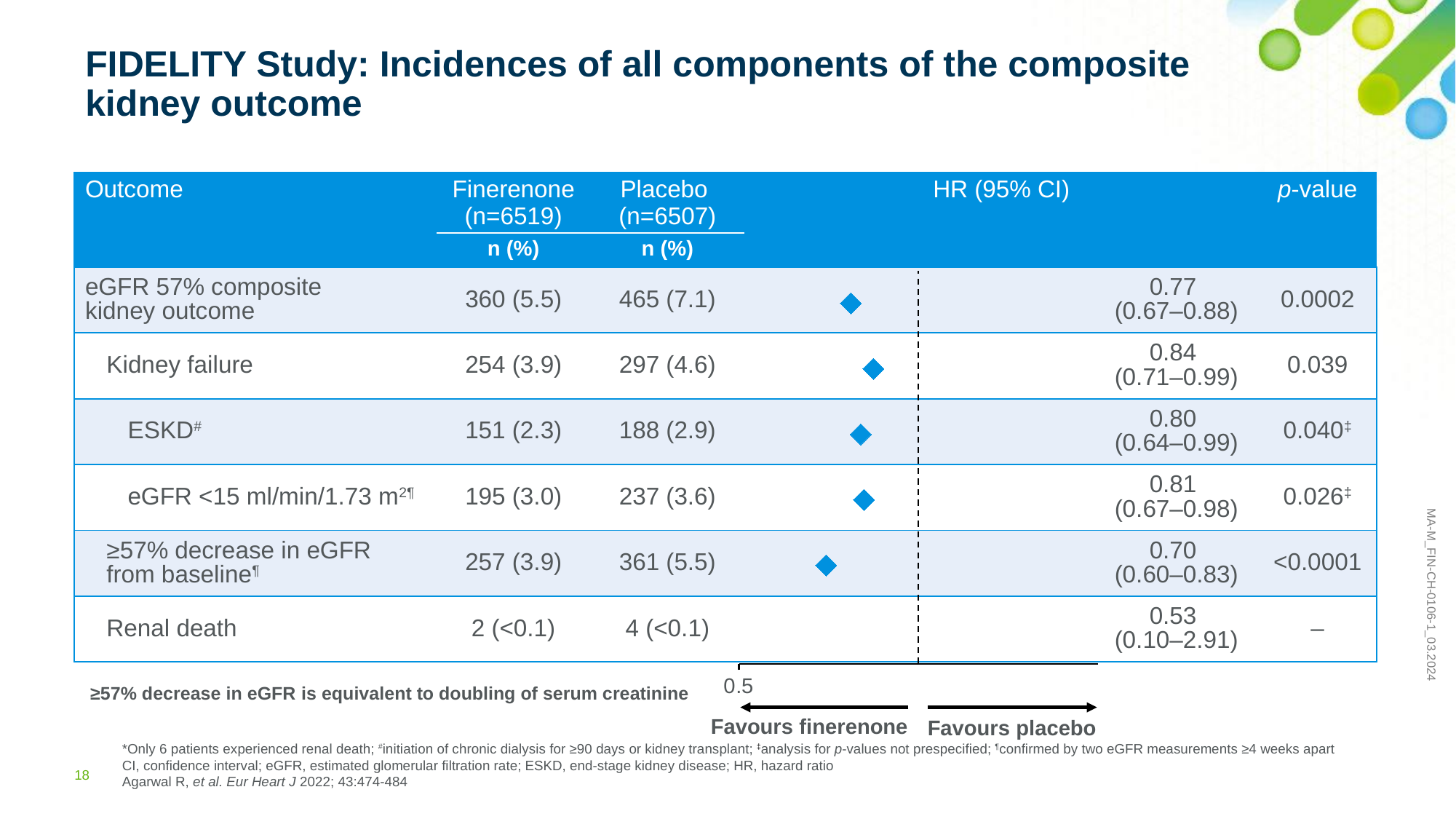
How many outcomes are listed in the table? 6 What is the p-value for the ≥57% decrease in eGFR from baseline outcome? <0.0001 Which outcome has the lowest hazard ratio in the table? Renal death (0.53) Which outcome has the highest hazard ratio in the table? Kidney failure (0.84) How many patients in the placebo group had the eGFR 57% composite kidney outcome? 465 (7.1) Is the hazard ratio for ESKD greater or less than 0.5? greater Which direction on the hazard ratio axis favours finerenone? Left (towards lower hazard ratios) Which has the larger hazard ratio: the eGFR 57% composite kidney outcome or kidney failure? Kidney failure What is the hazard ratio for kidney failure? 0.84 What is the hazard ratio (95% CI) for the eGFR 57% composite kidney outcome? 0.77 (0.67–0.88) What is the difference between the hazard ratio for kidney failure and the hazard ratio for ≥57% decrease in eGFR from baseline? 0.14 What kind of chart is shown alongside the table? Forest plot